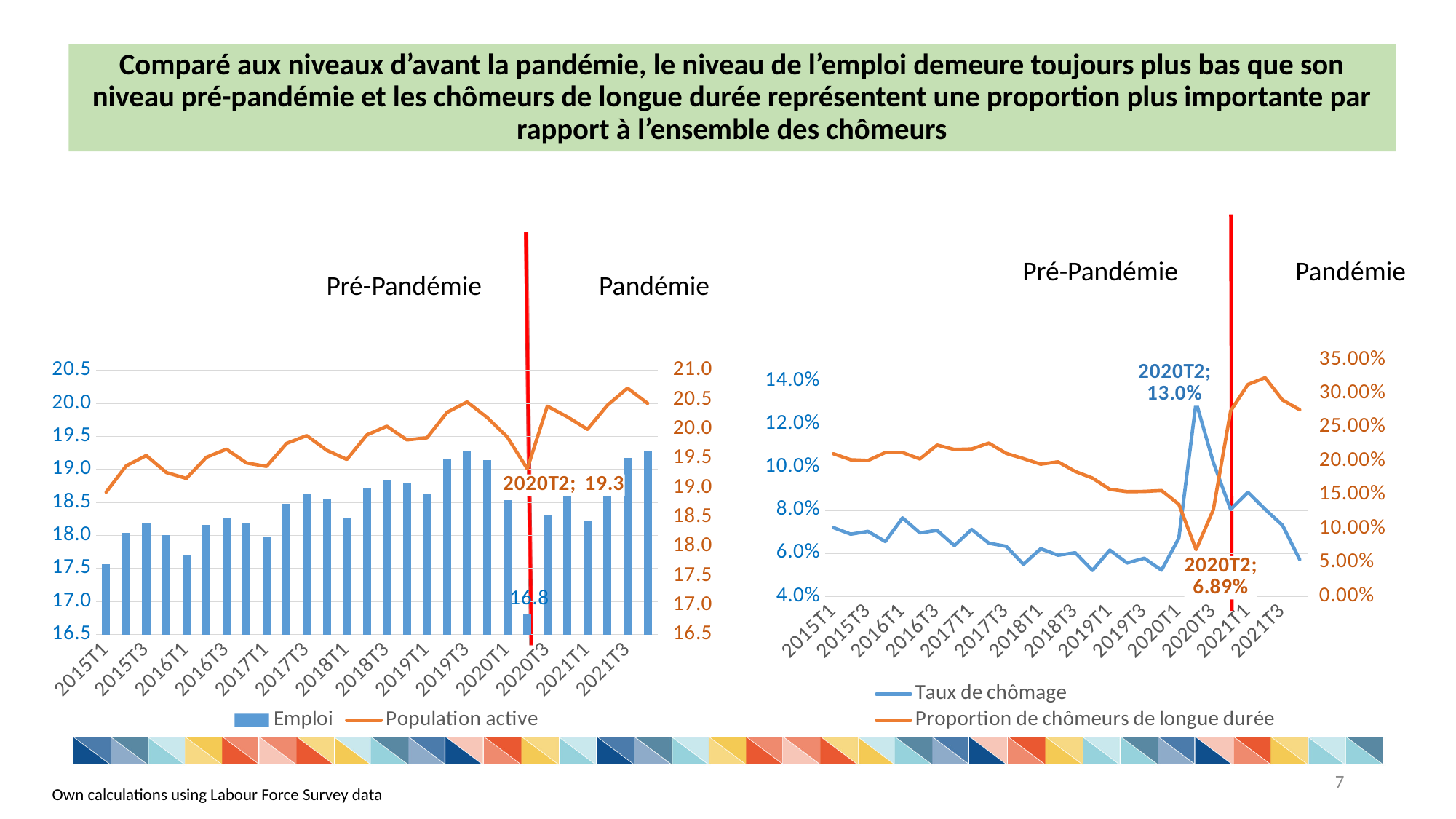
On the right chart, what is the Taux de chômage at 2020T2? 13.0% On the left chart, is the Emploi value for 2015T1 greater or less than 18.0? less On the right chart, is the Taux de chômage at 2021T4 greater or less than 6.0%? less On the right chart, is the Proportion de chômeurs de longue durée at 2021T2 greater or less than 30.00%? greater On the right chart, what is the Proportion de chômeurs de longue durée at 2020T2? 6.89% On the left chart, what is the value of Population active at 2020T2? 19.3 On the left chart, what is the value of Emploi at 2020T2? 16.8 On the left chart, which series is shown as bars? Emploi On the left chart, which quarter has the lowest Emploi value? 2020T2 On the right chart, how many series does the legend list? 2 On the left chart, how many series does the legend list? 2 On the right chart, which quarter has the highest Taux de chômage? 2020T2